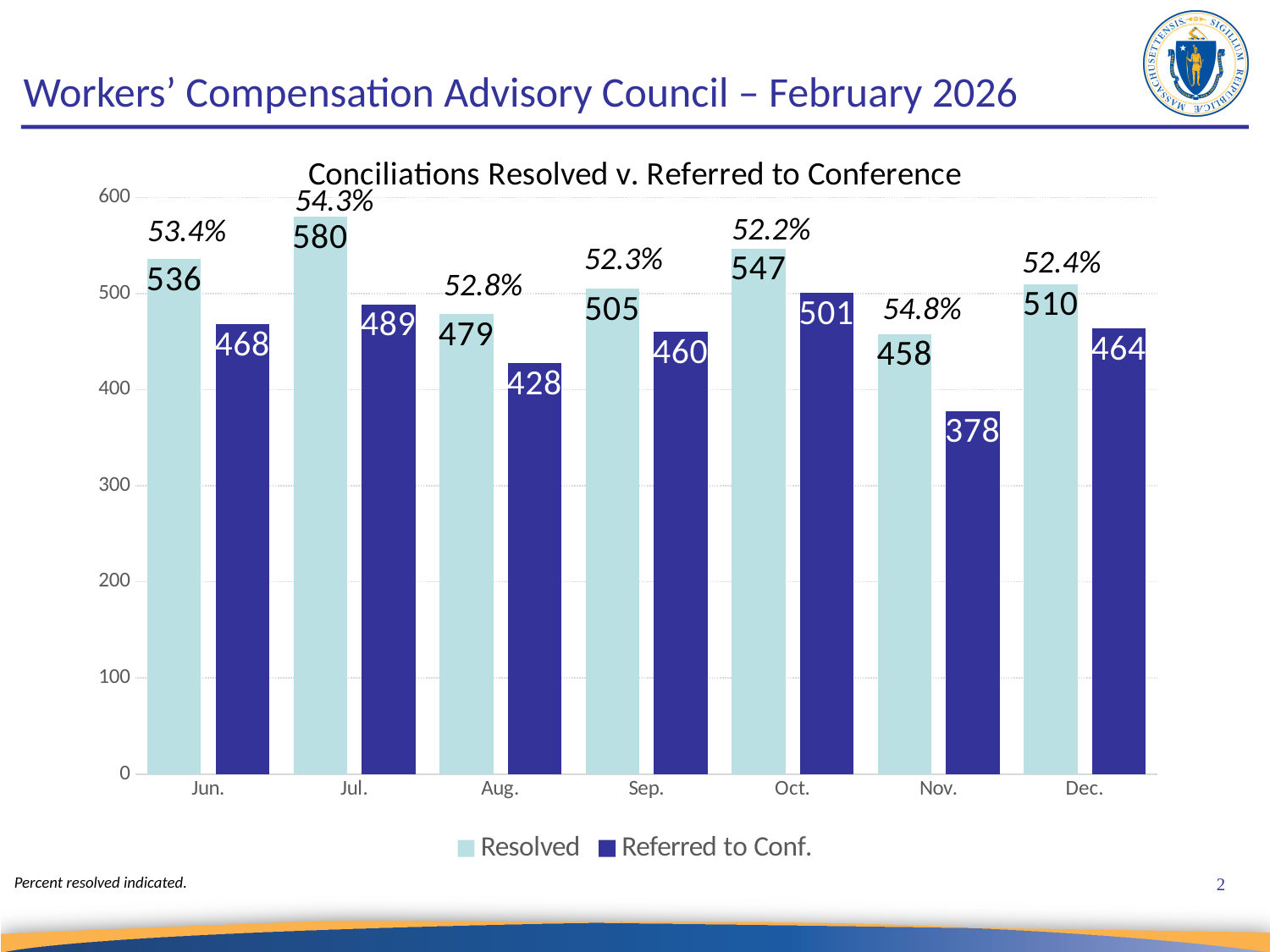
What is the Referred to Conf. value for Nov.? 378 What is the difference between the Resolved and Referred to Conf. values for Aug.? 51 How many series does the legend list? 2 Which is larger, the Referred to Conf. value for Jul. or for Dec.? Jul. What kind of chart is shown? bar chart What percent resolved is indicated for Oct.? 52.2% What is the title of the chart? Conciliations Resolved v. Referred to Conference Which month has the highest Resolved value? Jul. How many months are shown on the x axis? 7 Which month has the lowest Referred to Conf. value? Nov. What is the Resolved value for Jul.? 580 Is the Resolved value for Nov. greater or less than 500? less